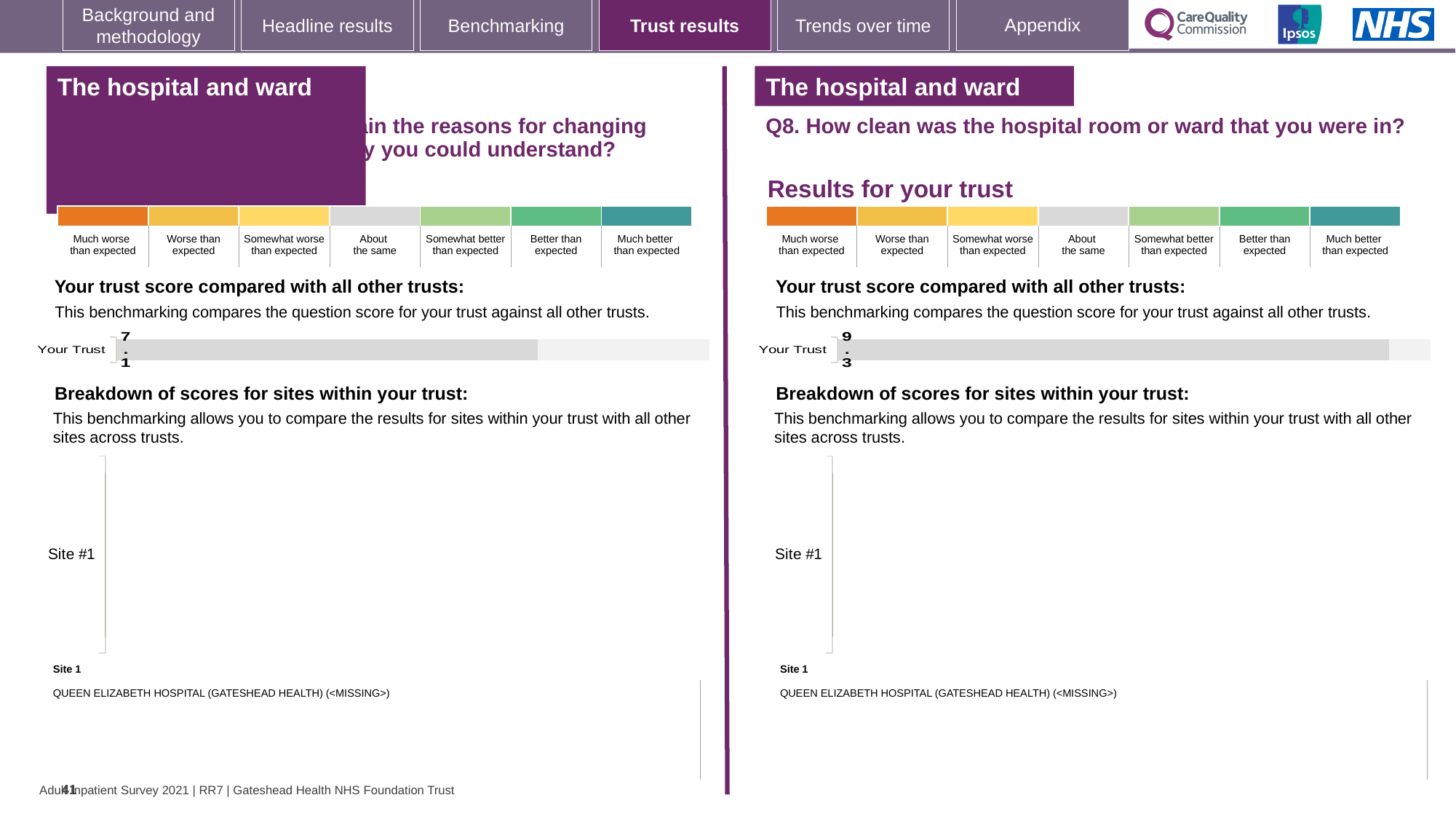
What is the label of the single bar in the 'Your trust score compared with all other trusts' chart on the left-hand panel? Your Trust What is the difference between the Your Trust score on the right-hand chart (Q8) and the Your Trust score on the left-hand chart? 2.2 On the right-hand chart (Q8. How clean was the hospital room or ward that you were in?), what is the score shown for Your Trust? 9.3 How many rating categories does the colour scale above the right-hand chart (Q8) list? 7 On the left-hand chart, what is the score shown for Your Trust? 7.1 What kind of chart is used to show the Your Trust score on the right-hand panel (Q8)? Bar chart Which is larger: the Your Trust score on the left-hand chart or the Your Trust score on the right-hand chart (Q8)? The right-hand chart (Q8), 9.3 Which site is listed as Site 1 beneath the right-hand chart (Q8)? QUEEN ELIZABETH HOSPITAL (GATESHEAD HEALTH) (<MISSING>) How many trust-level bars are plotted in the 'Your trust score compared with all other trusts' chart on the right-hand panel (Q8)? 1